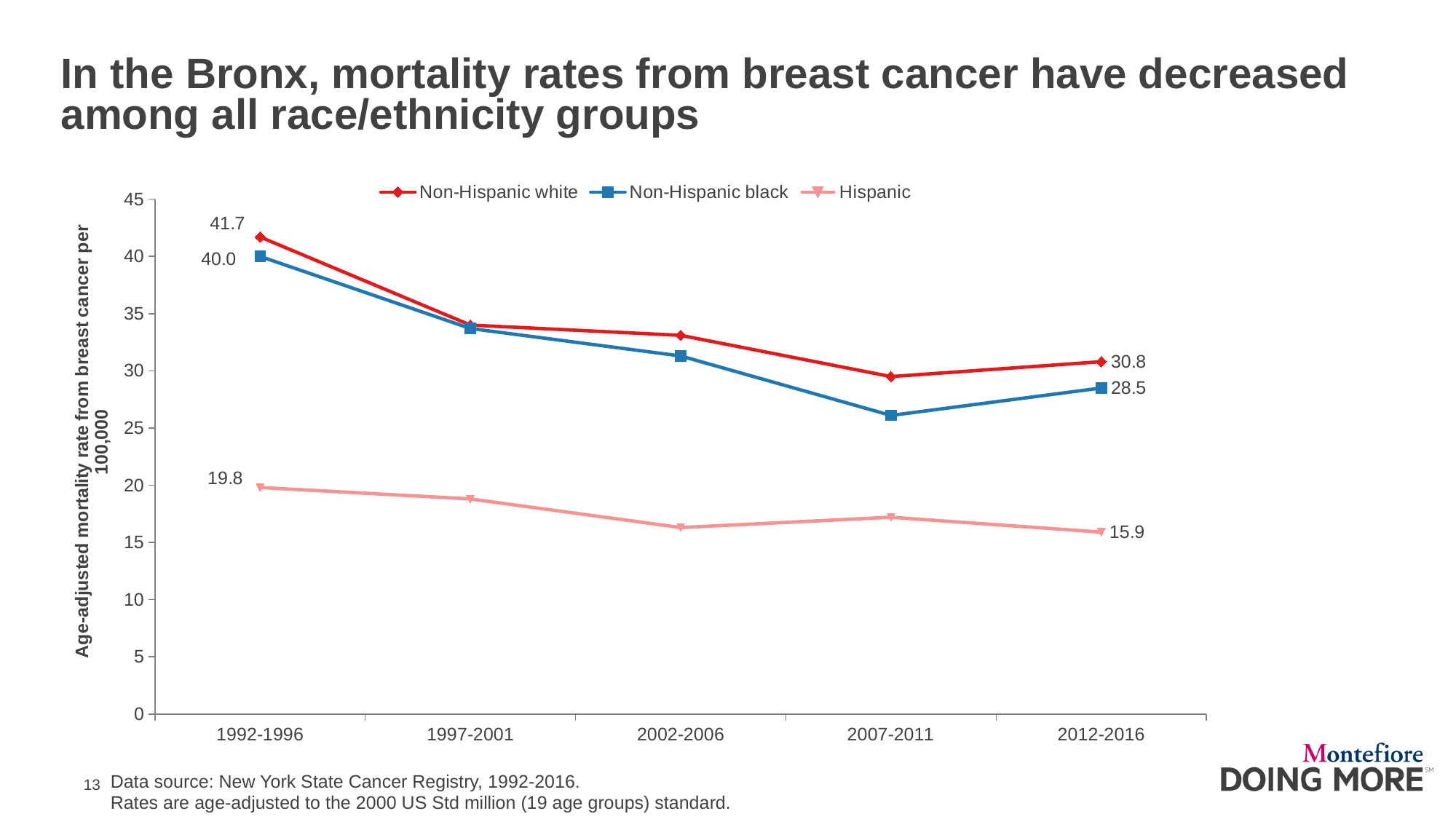
What is the age-adjusted breast cancer mortality rate for Non-Hispanic black women in 2012-2016? 28.5 Which race/ethnicity group has the highest mortality rate in 1992-1996? Non-Hispanic white How many series does the legend list? 3 What is the age-adjusted breast cancer mortality rate for Hispanic women in 1992-1996? 19.8 What is the age-adjusted breast cancer mortality rate for Non-Hispanic white women in 1992-1996? 41.7 How many time periods are shown on the x axis? 5 By how much did the Non-Hispanic white mortality rate fall from 1992-1996 to 2012-2016? 10.9 Which race/ethnicity group has the lowest mortality rate in 2012-2016? Hispanic What kind of chart is shown on the slide? Line chart By how much did the Non-Hispanic black mortality rate fall from 1992-1996 to 2012-2016? 11.5 Is the Non-Hispanic black mortality rate in 2007-2011 greater or less than 30? less What is the age-adjusted breast cancer mortality rate for Hispanic women in 2012-2016? 15.9